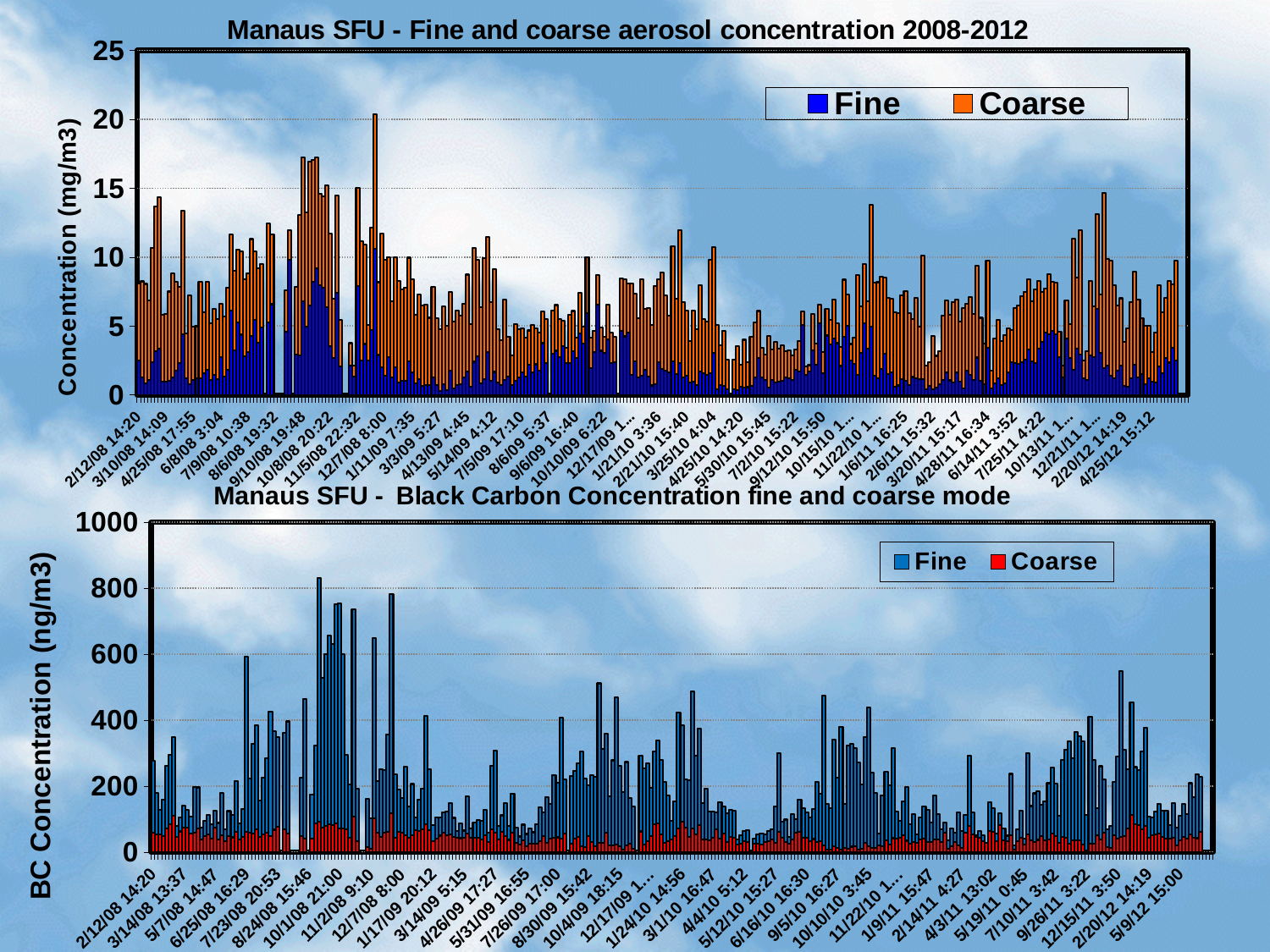
How many series does the legend of the top chart list? 2 What kind of chart is the bottom chart, 'Manaus SFU - Black Carbon Concentration fine and coarse mode'? Bar chart In the top chart, is the tallest stacked bar greater or less than 15? greater In the bottom chart, is the tallest Fine bar greater or less than 600? greater What kind of chart is the top chart, 'Manaus SFU - Fine and coarse aerosol concentration 2008-2012'? Bar chart In the top chart, which series generally contributes more to the stacked bars, Fine or Coarse? Coarse In the bottom chart, are the Coarse values generally greater or less than 200? less In the top chart, what are the two series named in the legend? Fine and Coarse What is the y-axis label of the bottom chart? BC Concentration (ng/m3) In the bottom chart, which series generally has the larger values, Fine or Coarse? Fine How many series does the legend of the bottom chart list? 2